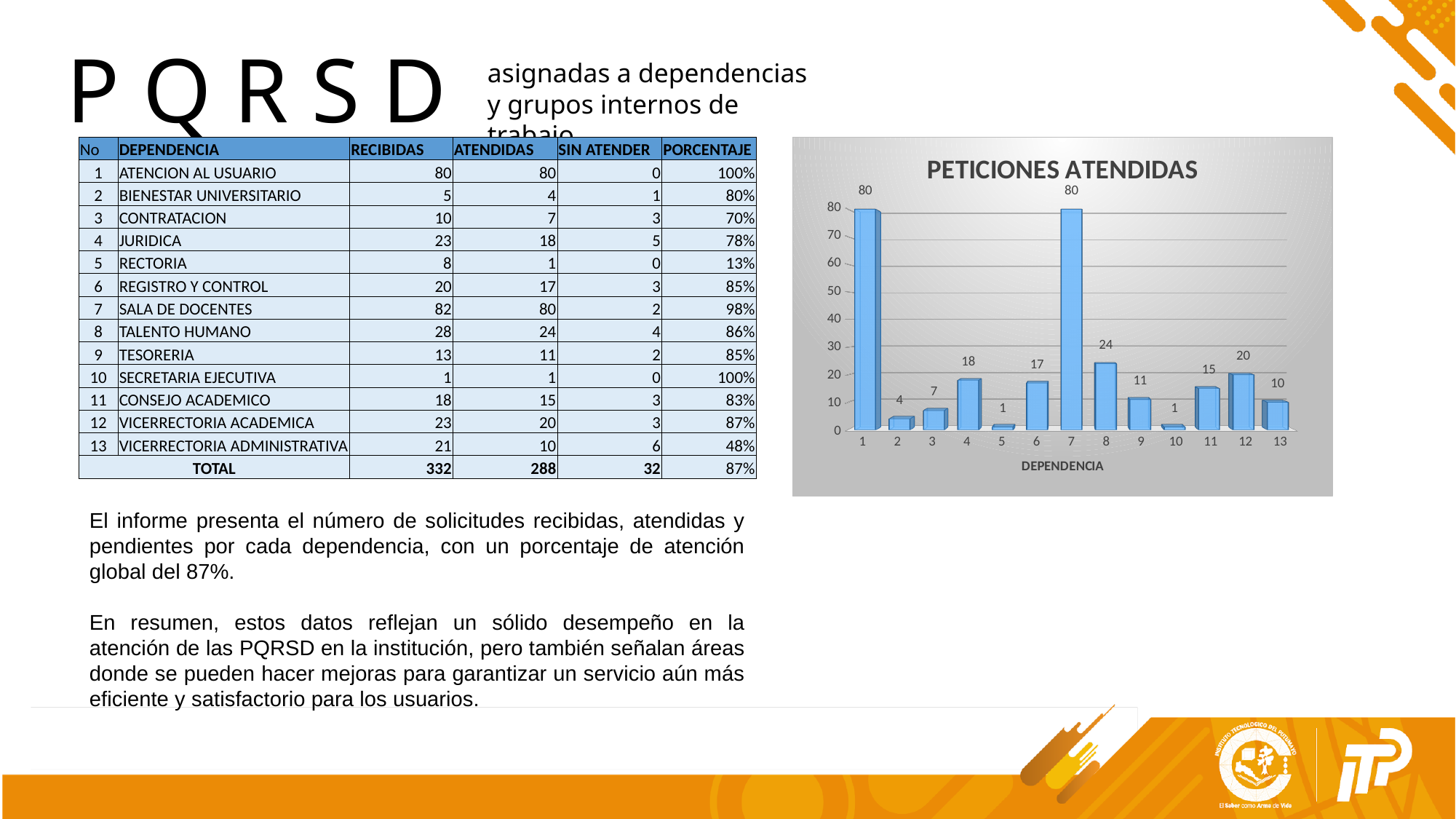
In the PETICIONES ATENDIDAS chart, which has a larger value, dependencia 6 or dependencia 11? dependencia 6 What is the title of the x axis in the PETICIONES ATENDIDAS chart? DEPENDENCIA In the PETICIONES ATENDIDAS chart, what is the value for dependencia 8? 24 In the PETICIONES ATENDIDAS chart, what is the difference between the values for dependencia 1 and dependencia 2? 76 In the PETICIONES ATENDIDAS chart, what is the difference between the values for dependencia 8 and dependencia 9? 13 In the PETICIONES ATENDIDAS chart, what is the value for dependencia 12? 20 In the PETICIONES ATENDIDAS chart, what is the value for dependencia 13? 10 What type of chart is shown under the title PETICIONES ATENDIDAS? bar chart In the PETICIONES ATENDIDAS chart, what is the highest value shown by any bar? 80 In the PETICIONES ATENDIDAS chart, what is the value for dependencia 4? 18 In the PETICIONES ATENDIDAS chart, is the value for dependencia 8 greater or less than 20? greater How many dependencias are plotted on the x axis of the PETICIONES ATENDIDAS chart? 13